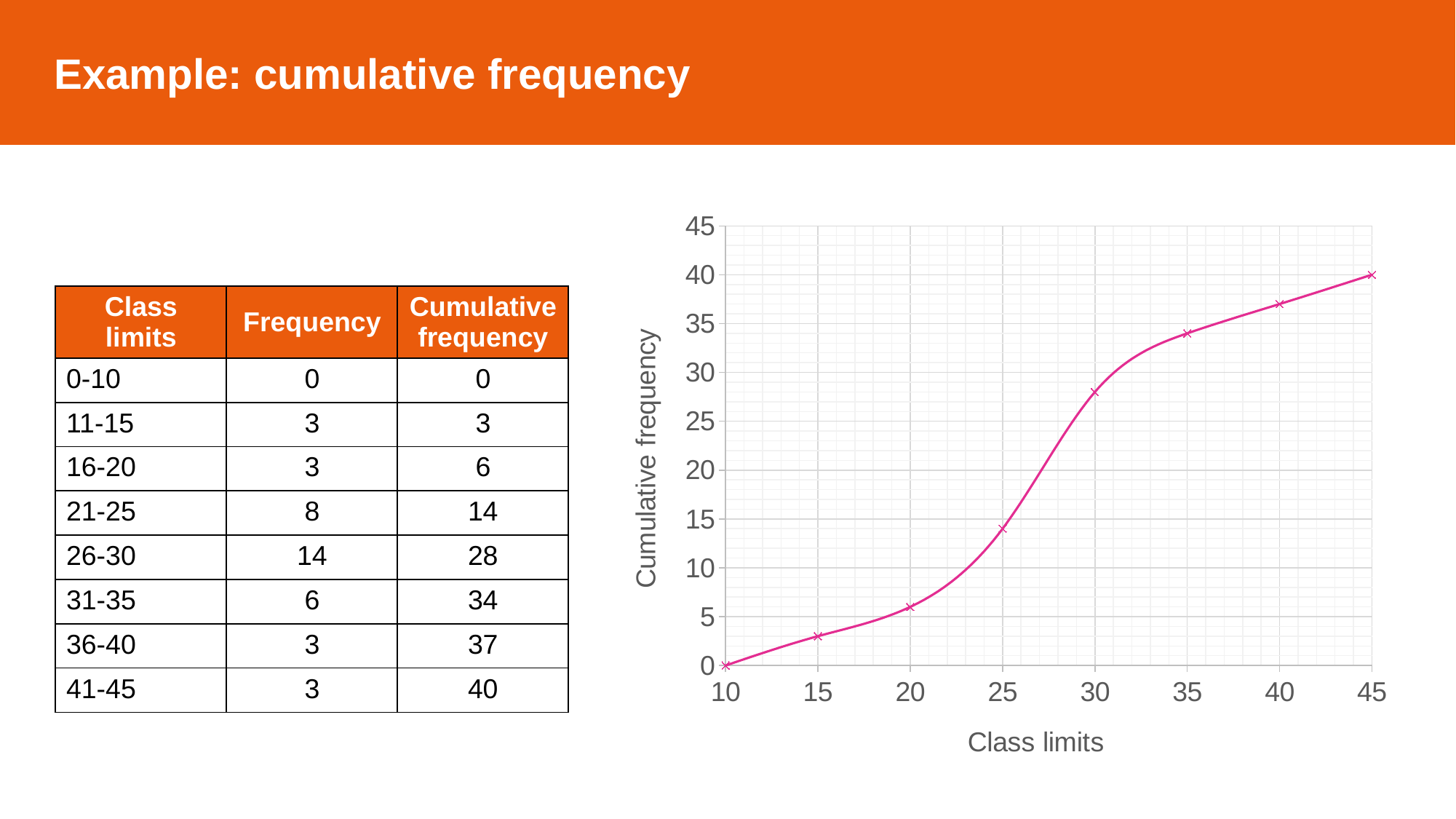
At which class limit is the cumulative frequency lowest? 10 What is the label on the vertical axis of the chart? Cumulative frequency Is the cumulative frequency at class limit 35 greater or less than 35? less Is the cumulative frequency at class limit 30 greater or less than 25? greater How many data points are plotted on the line chart? 8 At which class limit is the cumulative frequency highest? 45 What is the cumulative frequency plotted at class limit 10? 0 Which has the larger cumulative frequency, class limit 20 or class limit 30? 30 What is the cumulative frequency plotted at class limit 45? 40 Is the cumulative frequency at class limit 25 greater or less than 15? less Does the cumulative frequency rise or fall as the class limit increases along the x axis? rises What kind of chart is shown on the slide? line chart